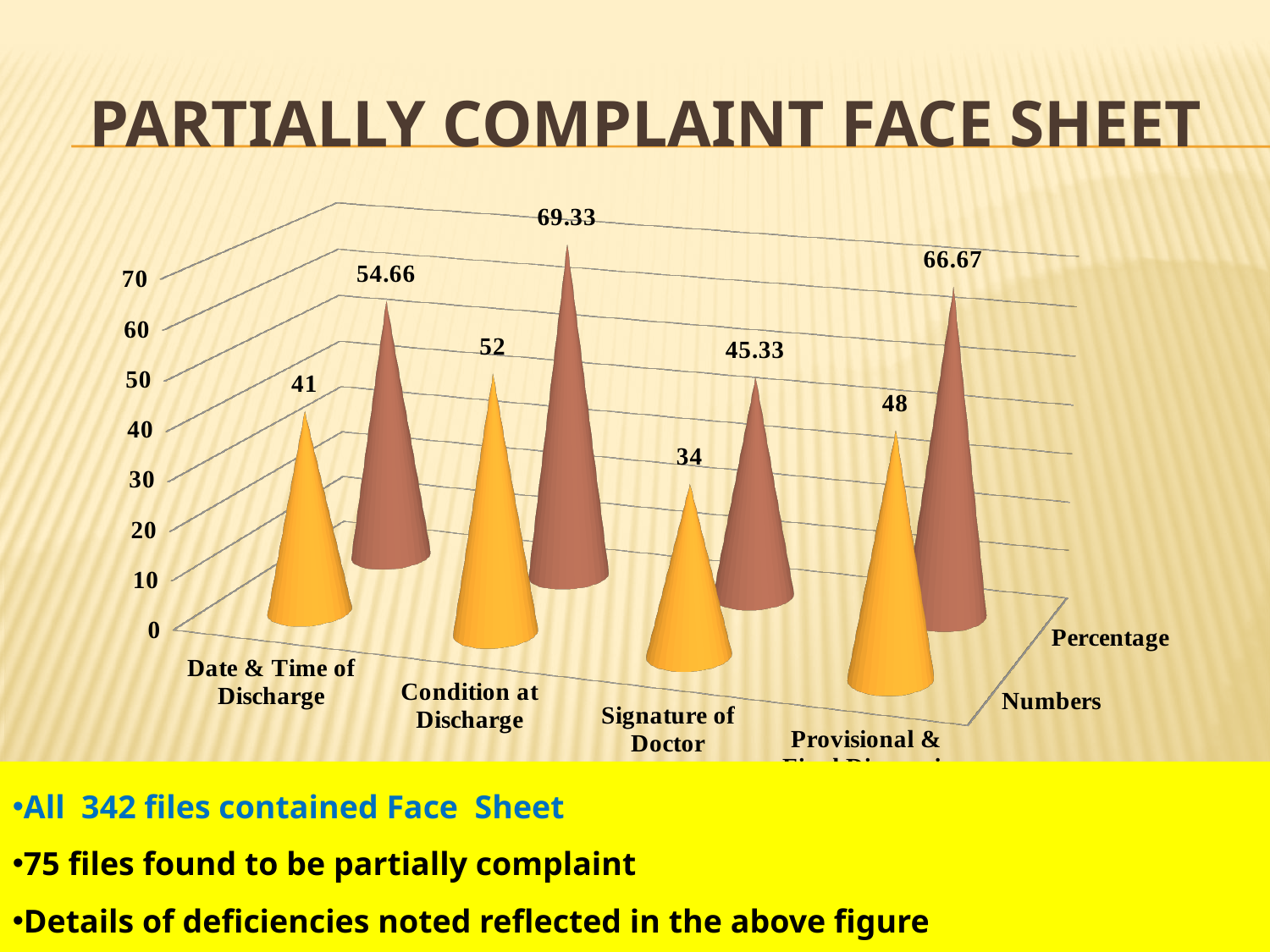
Which has the larger Numbers value, Date & Time of Discharge or Signature of Doctor? Date & Time of Discharge What is the difference between the Percentage values for Condition at Discharge and Date & Time of Discharge? 14.67 What kind of chart is shown on the slide? bar chart What is the Numbers value for Date & Time of Discharge? 41 What is the difference between the Numbers values for Condition at Discharge and Signature of Doctor? 18 Which category has the highest Numbers value? Condition at Discharge What is the Percentage value for Condition at Discharge? 69.33 What is the Percentage value for Signature of Doctor? 45.33 What is the Numbers value for Signature of Doctor? 34 Which category has the lowest Percentage value? Signature of Doctor How many data series are plotted on the chart? 2 How many categories are shown on the chart? 4